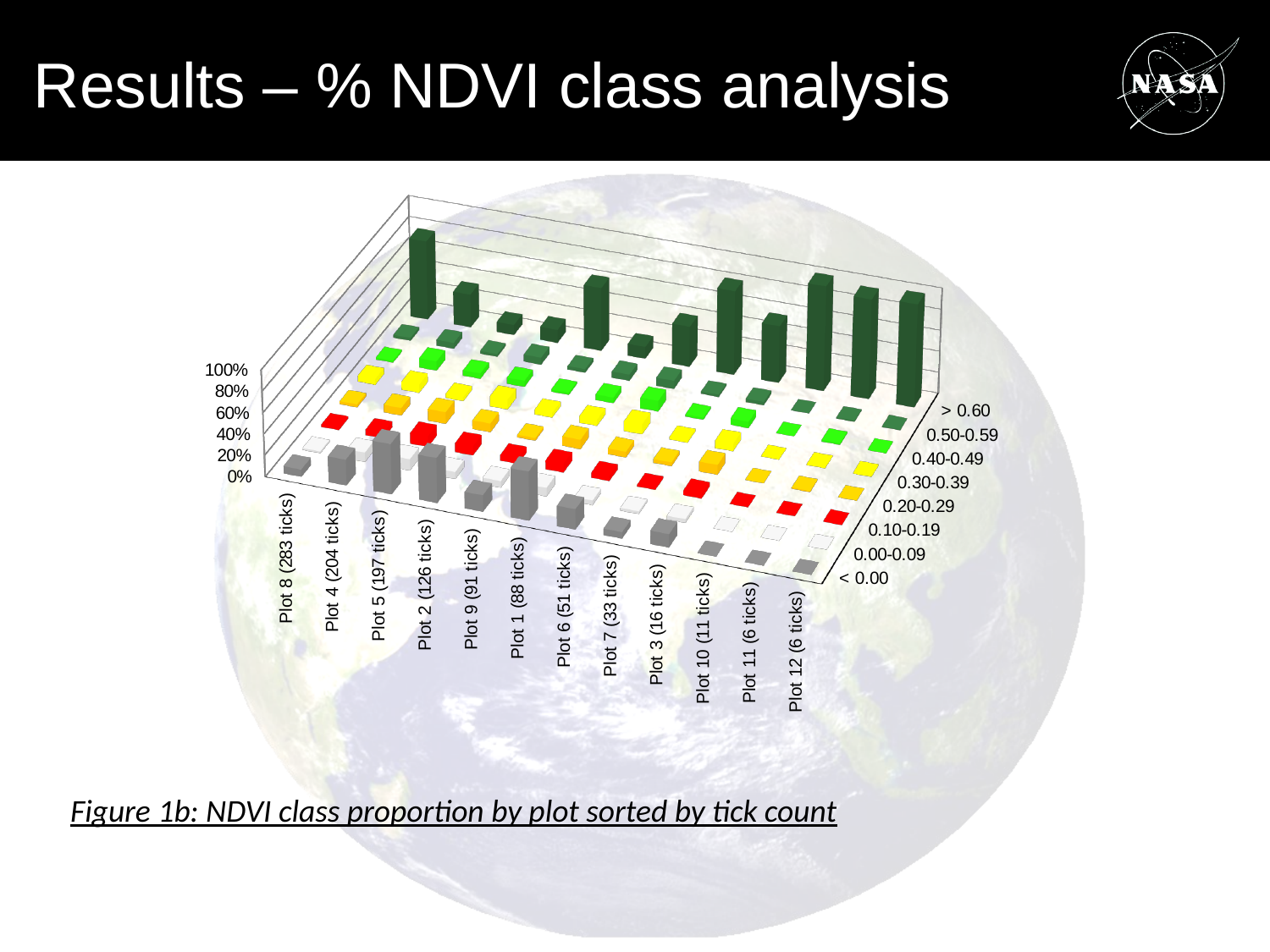
How many ticks are given in the axis label for Plot 2? 126 ticks What is the highest value shown on the chart's vertical axis? 100% What kind of chart is shown on the slide? 3D bar chart How many ticks are given in the axis label for Plot 5? 197 ticks How many NDVI class series does the chart's legend list? 8 How many plots (categories) are shown along the x axis of the chart? 12 Which has more ticks according to the axis labels, Plot 9 or Plot 1? Plot 9 (91 ticks) Do the tick counts in the axis labels rise or fall from left to right along the x axis? fall Which plot is listed first on the x axis of the chart? Plot 8 (283 ticks) Which plot has the highest tick count according to the axis labels? Plot 8 (283 ticks) What is the difference in tick count between Plot 8 and Plot 4 according to the axis labels? 79 ticks Which NDVI class is listed first (topmost) in the chart legend? > 0.60